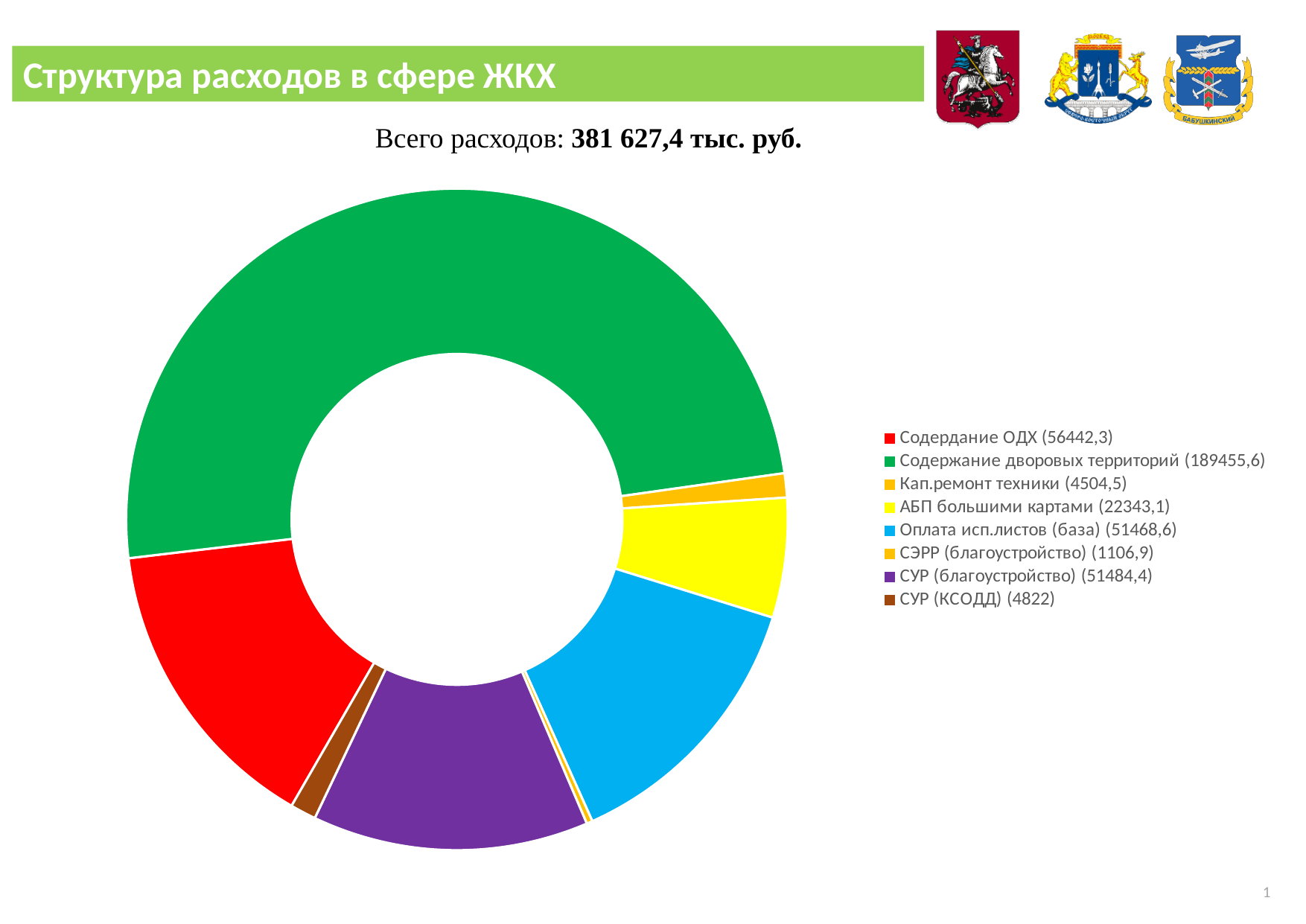
What total expenditure is stated above the chart? 381 627,4 тыс. руб. What is the value for Оплата исп.листов (база)? 51468,6 What is the value for СУР (КСОДД)? 4822 How many categories does the legend of the chart list? 8 What is the difference between АБП большими картами and Кап.ремонт техники? 17838,6 What is the difference between Содержание дворовых территорий and Содердание ОДХ? 133013,3 Which category has the largest value? Содержание дворовых территорий What type of chart is shown on the slide? Doughnut (pie) chart What is the value for СЭРР (благоустройство)? 1106,9 Which is larger: Содердание ОДХ or АБП большими картами? Содердание ОДХ What is the value for Содержание дворовых территорий? 189455,6 Which category has the smallest value? СЭРР (благоустройство)